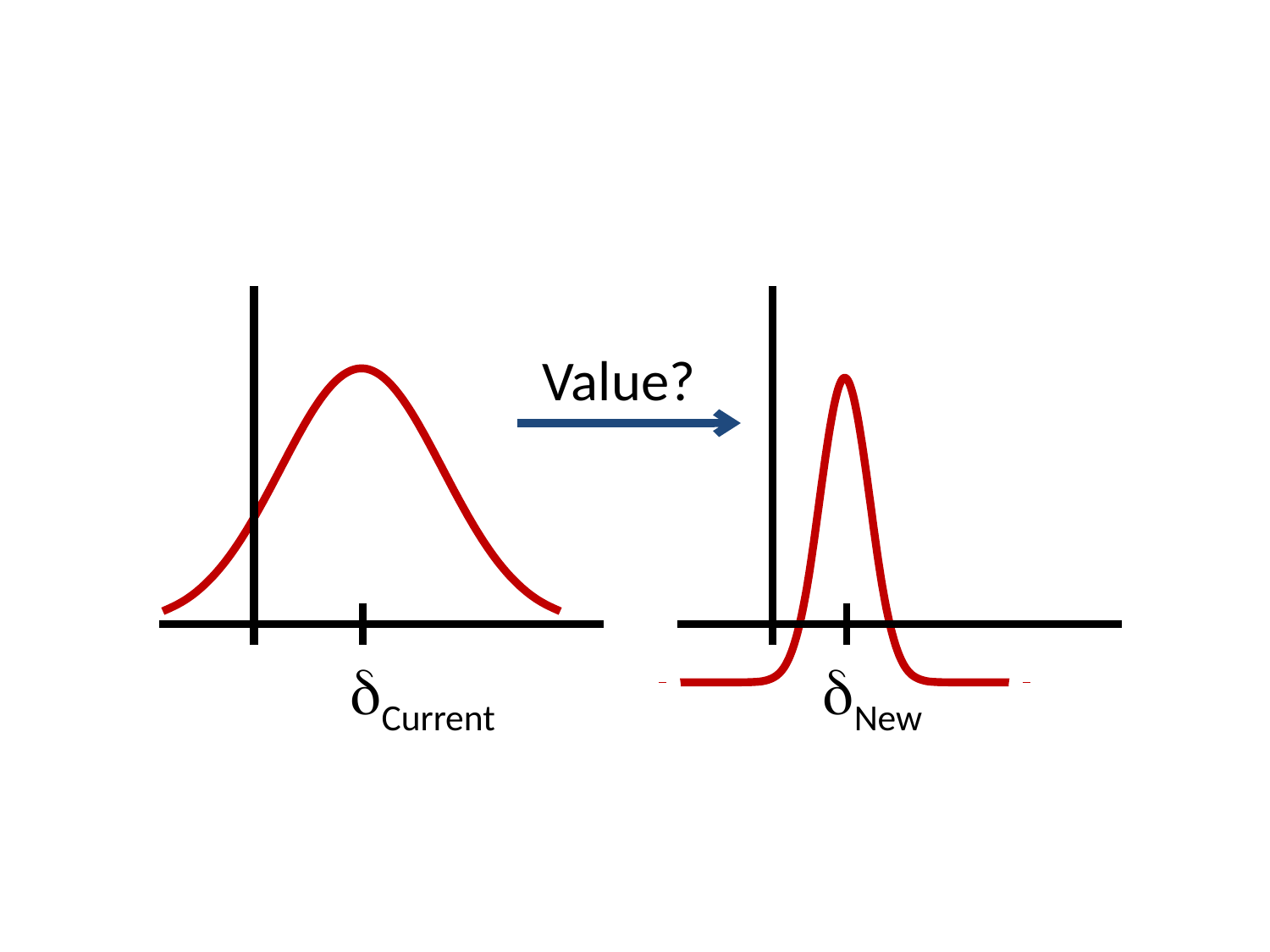
Which chart shows the narrower curve, the left (δCurrent) or the right (δNew)? the right (δNew) How many curves are plotted in the left chart? 1 How many charts are shown on the slide? 2 What label appears under the x-axis tick of the left chart? δCurrent Which chart shows the wider curve, the left (δCurrent) or the right (δNew)? the left (δCurrent) What label appears under the x-axis tick of the right chart? δNew How many curves are plotted in the right chart? 1